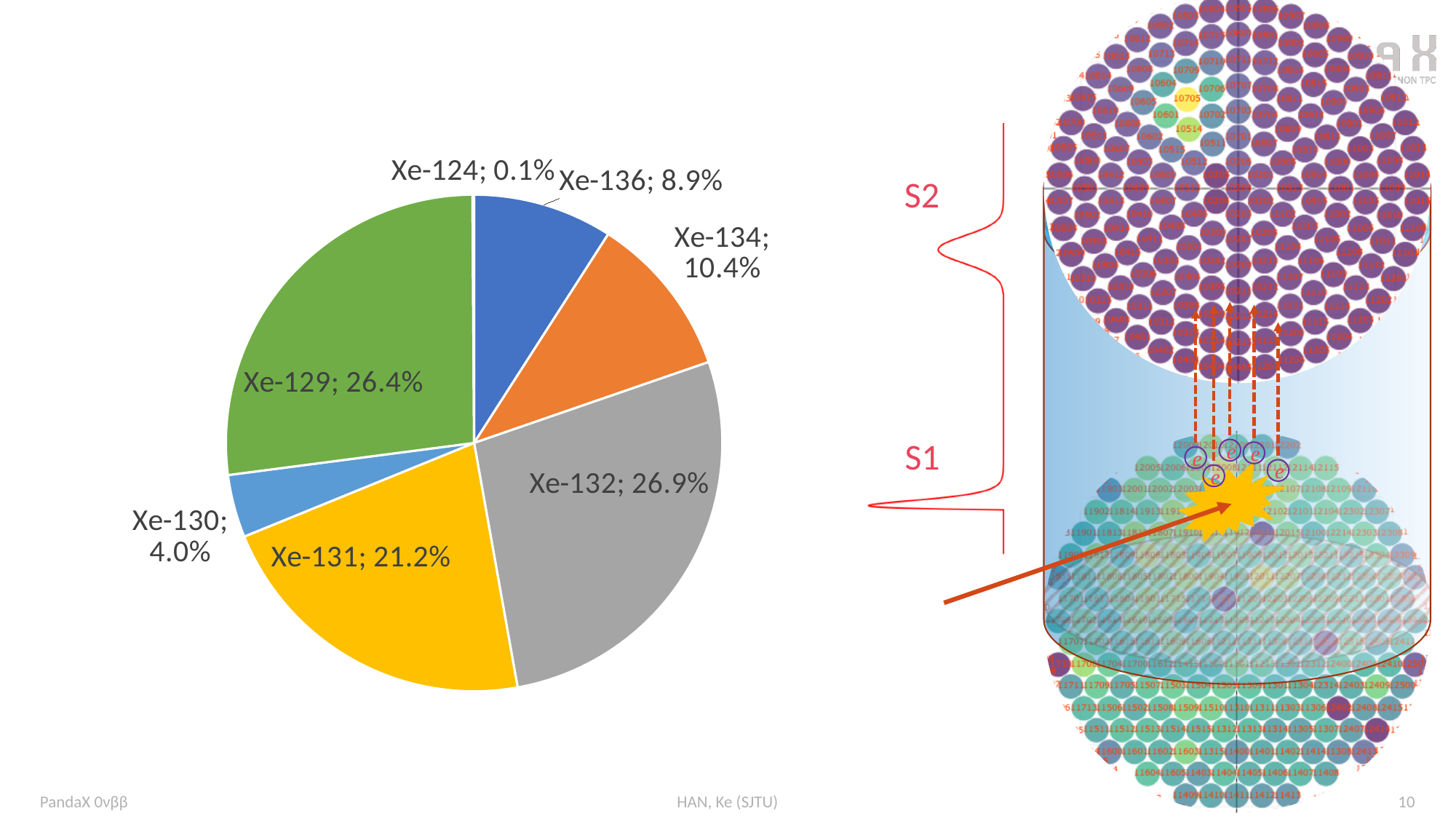
Which is larger in the pie chart, the share of Xe-134 or the share of Xe-136? Xe-134 How many slices does the pie chart have? 7 What is the difference between the shares of Xe-134 and Xe-130 in the pie chart? 6.4% What is the share for Xe-130 in the pie chart? 4.0% What is the difference between the shares of Xe-129 and Xe-131 in the pie chart? 5.2% What colour is the Xe-131 slice in the pie chart? yellow What is the share for Xe-131 in the pie chart? 21.2% Which isotope has the smallest slice in the pie chart? Xe-124 Which isotope has the largest slice in the pie chart? Xe-132 What is the share for Xe-132 in the pie chart? 26.9% What kind of chart is shown on the left of the slide? pie chart What is the share for Xe-136 in the pie chart? 8.9%